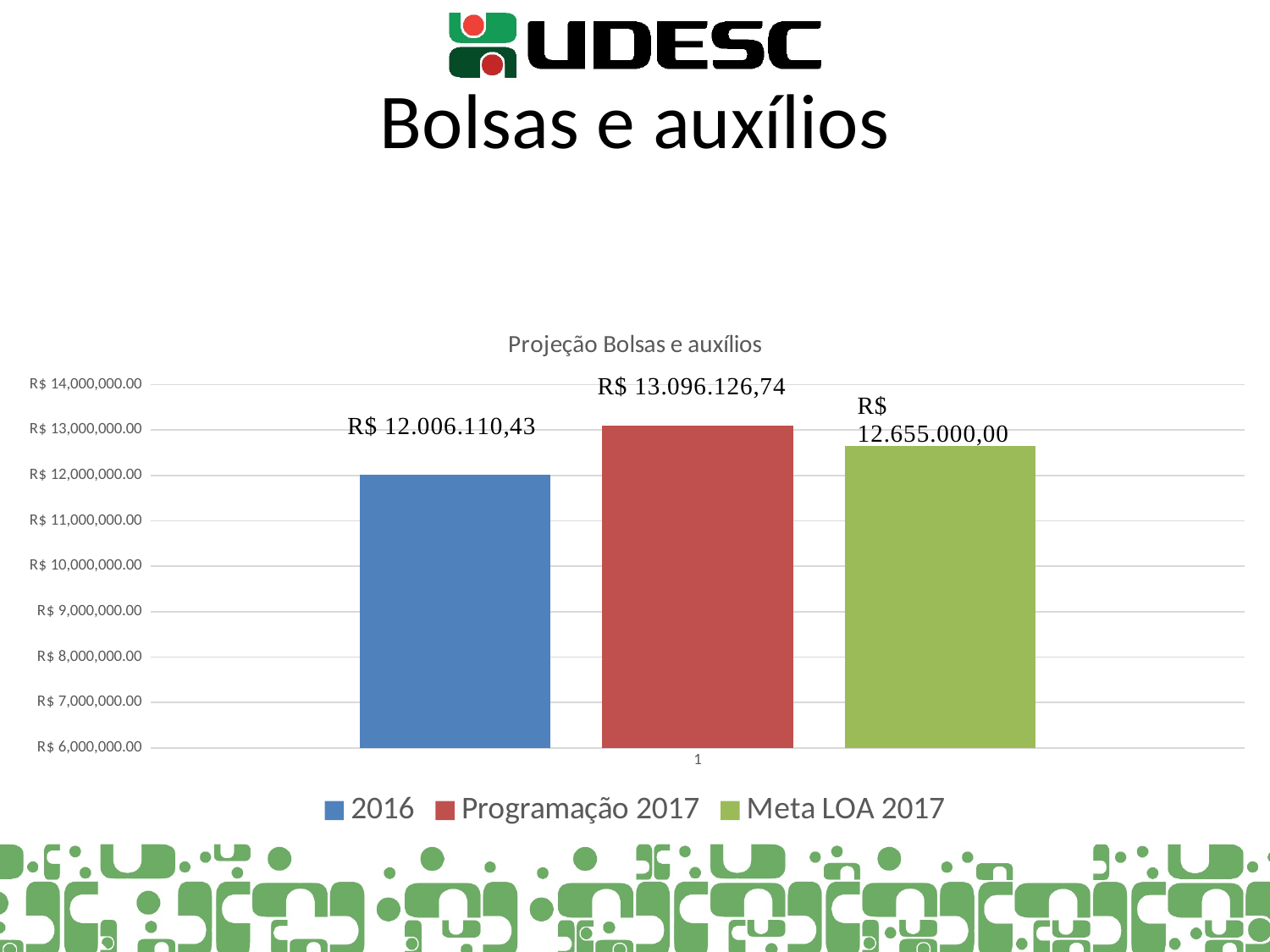
What is the title of the chart? Projeção Bolsas e auxílios Which series has the highest value in the chart? Programação 2017 What is the difference between the Programação 2017 value and the Meta LOA 2017 value? R$ 441.126,74 Is the value for Programação 2017 greater or less than R$ 13,000,000.00? greater What kind of chart is shown on the slide? Bar chart What is the value for Meta LOA 2017 in the chart? R$ 12.655.000,00 What is the value for the 2016 series in the Projeção Bolsas e auxílios chart? R$ 12.006.110,43 How many series does the legend list? 3 Which series has the lowest value in the chart? 2016 Which is larger, the value for Meta LOA 2017 or the value for 2016? Meta LOA 2017 What is the difference between the Programação 2017 value and the 2016 value? R$ 1.090.016,31 What is the value for Programação 2017 in the chart? R$ 13.096.126,74